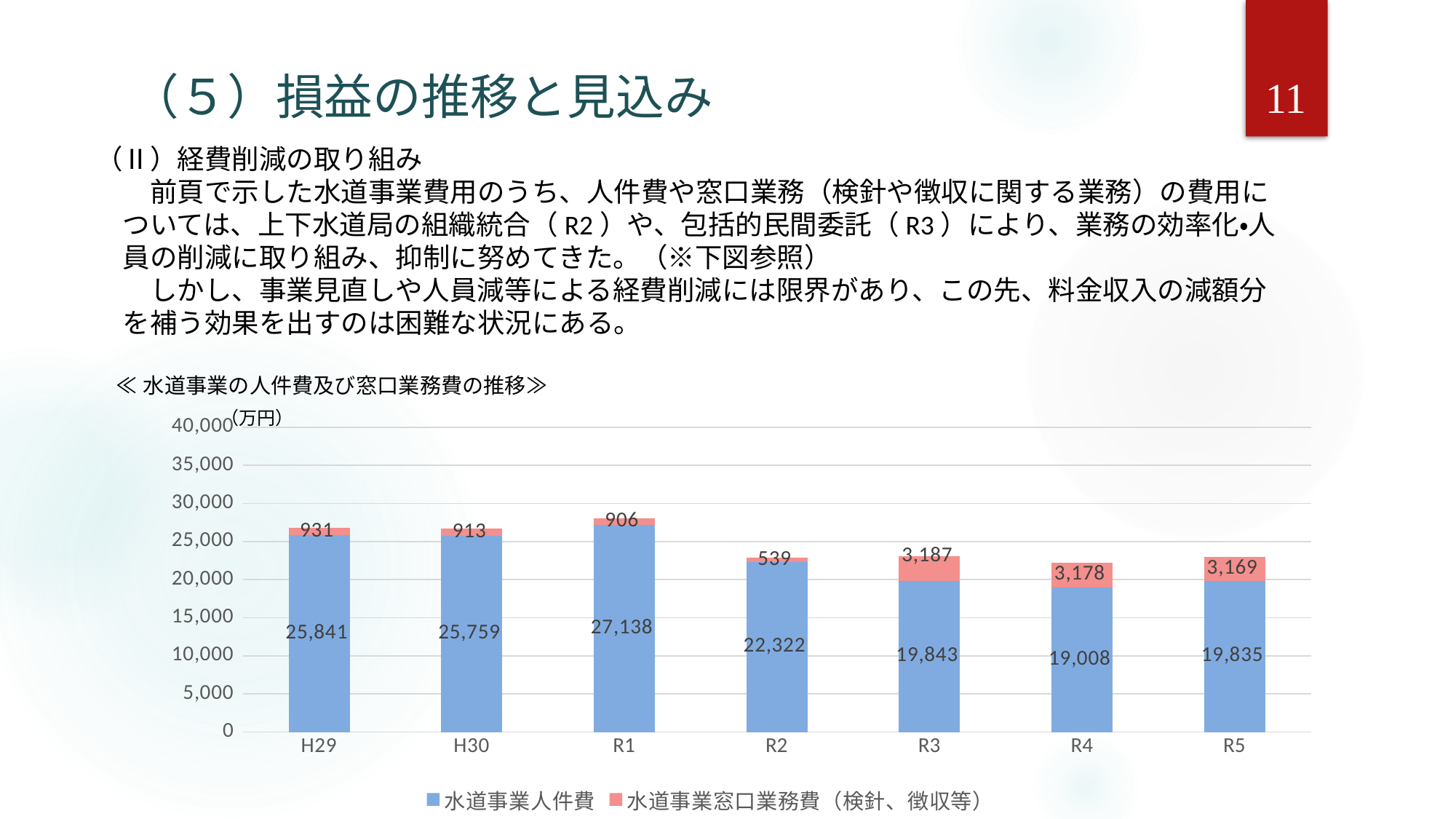
What unit is shown at the top of the y axis? 万円 What is the total of the stacked bar for R1? 28,044 How many categories are shown on the x axis? 7 What is the value of 水道事業人件費 for R4? 19,008 Which is larger, the 水道事業窓口業務費（検針、徴収等） value for H30 or for R4? R4 What type of chart is shown on the slide? Stacked bar chart Which category has the lowest value for 水道事業窓口業務費（検針、徴収等）? R2 What is the difference between the 水道事業人件費 values for H29 and R5? 6,006 What is the value of 水道事業窓口業務費（検針、徴収等） for R3? 3,187 How many series does the legend list? 2 What is the value of 水道事業人件費 for R1? 27,138 Which category has the highest value for 水道事業人件費? R1